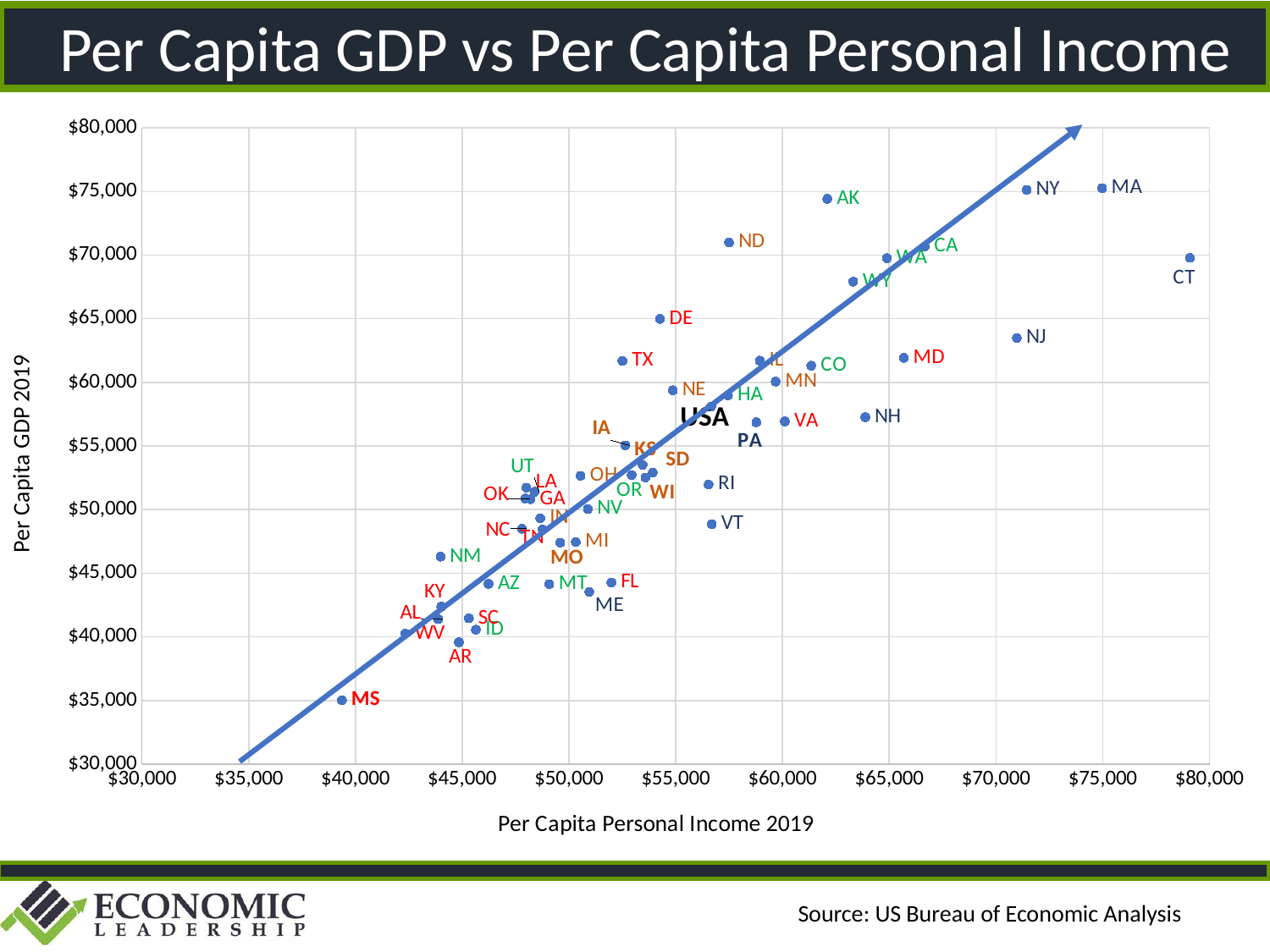
What is the title of the x axis? Per Capita Personal Income 2019 Which state has the highest per capita personal income on the chart? CT Is the per capita GDP for VT greater or less than $50,000? less What kind of chart is shown on the slide? Scatter chart Do per capita GDP values generally rise or fall as per capita personal income increases along the x axis? rise Which state has the lowest per capita GDP on the chart? MS What is the title of the y axis? Per Capita GDP 2019 Is the per capita GDP for AK greater or less than $70,000? greater Which has the higher per capita GDP, DE or TX? DE Which state has the lowest per capita personal income on the chart? MS Is the per capita GDP for MS greater or less than $40,000? less